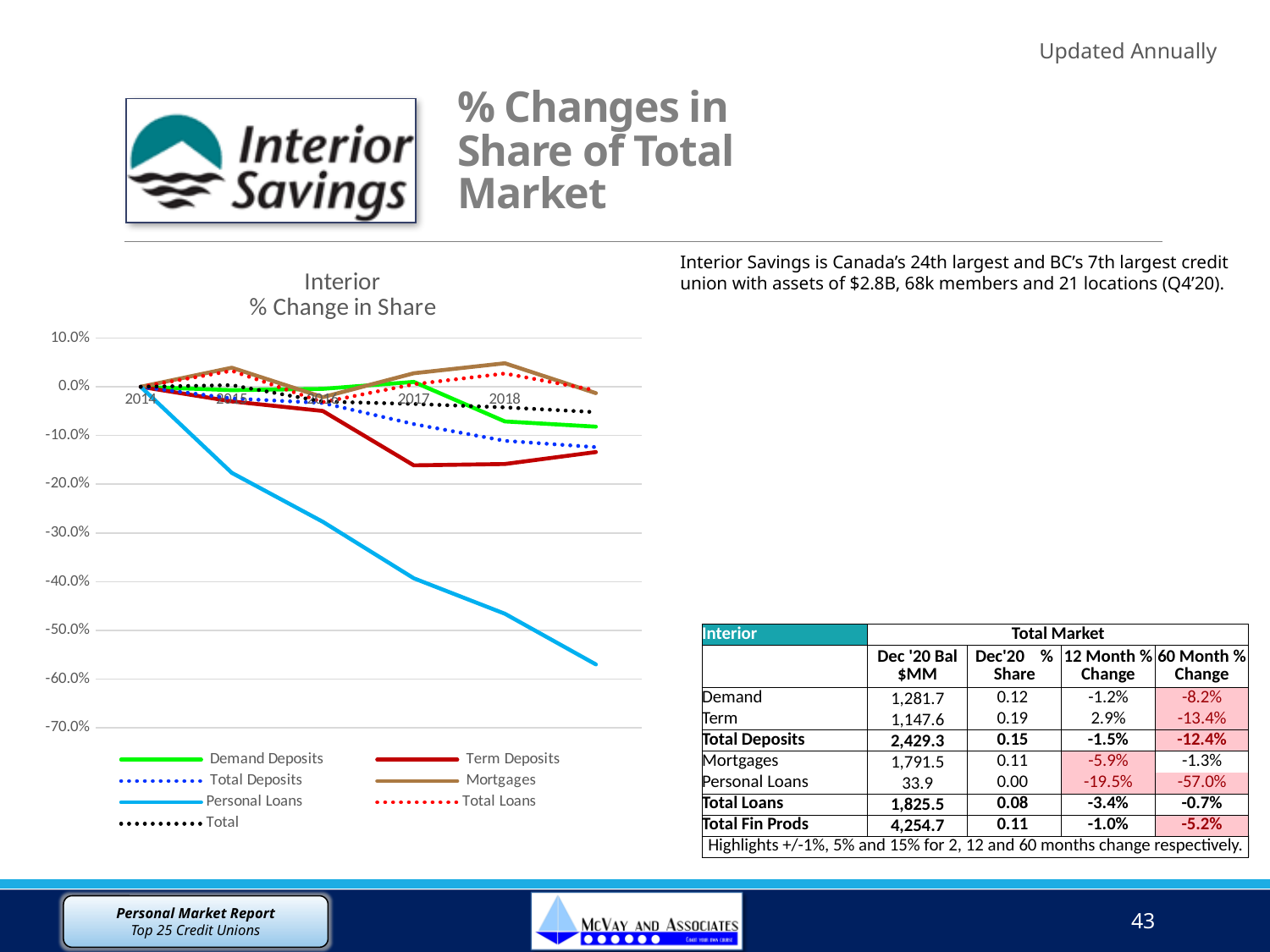
Do the values for Personal Loans rise or fall from 2014 to the end of the chart? fall How many series does the legend of the chart list? 7 Is the value for Mortgages in 2018 greater or less than 0.0%? greater Is the final value for Personal Loans greater or less than -50.0%? less At the right end of the chart, which is higher: Mortgages or Personal Loans? Mortgages Which series has the lowest value at the right end of the chart? Personal Loans Is the final value for Total Deposits greater or less than -10.0%? less Which series has the highest value in 2018? Mortgages What kind of chart is shown on the slide? Line chart Which series is drawn as a solid light blue line in the chart? Personal Loans What is the title of the chart? Interior % Change in Share